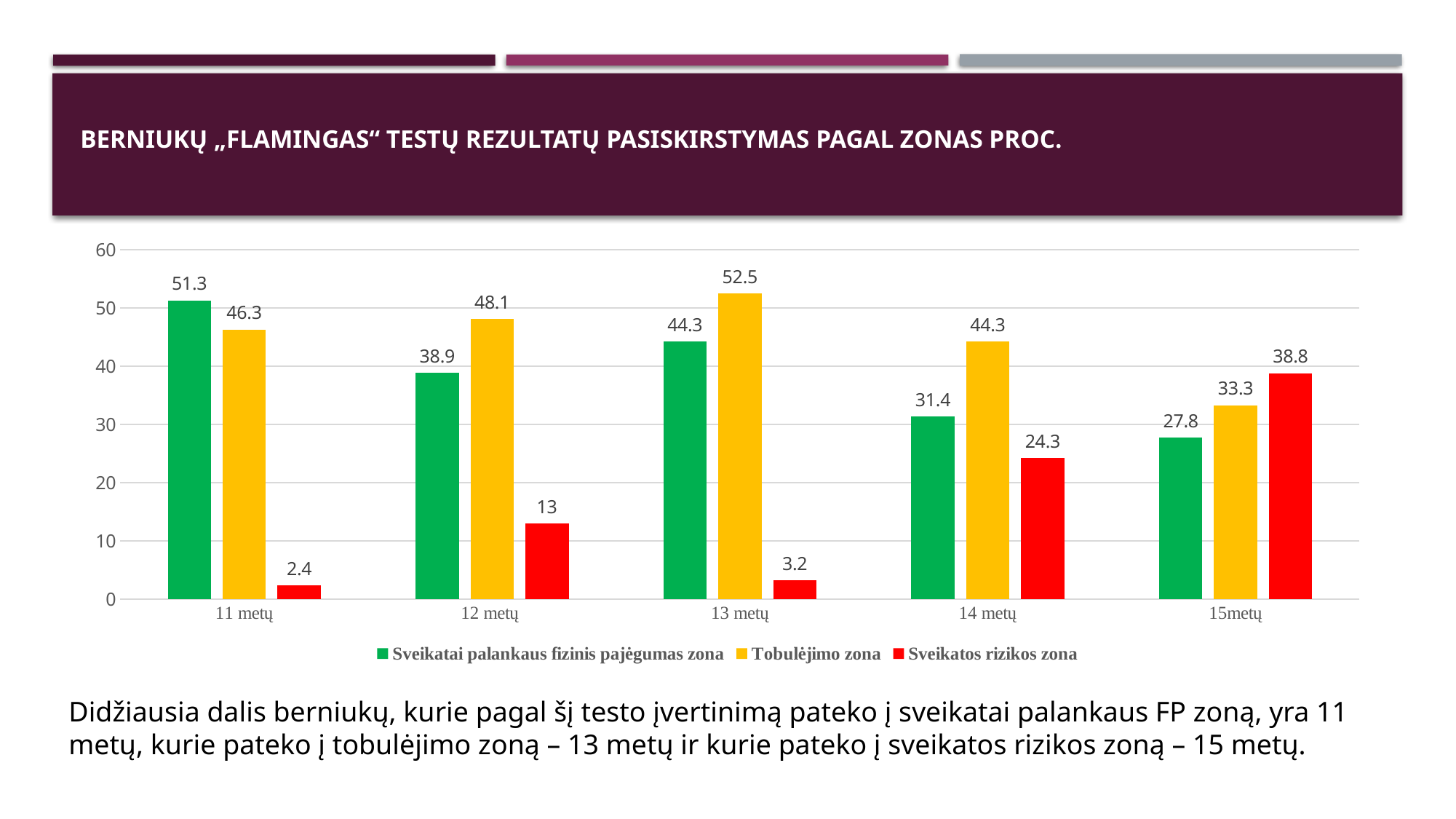
What is the value for Tobulėjimo zona at 13 metų? 52.5 What kind of chart is shown on the slide? Bar chart Which age group has the highest value for Sveikatos rizikos zona? 15metų What is the difference between the Tobulėjimo zona value and the Sveikatos rizikos zona value at 14 metų? 20 What is the value for Sveikatai palankaus fizinis pajėgumas zona at 11 metų? 51.3 Which age group has the lowest value for Sveikatai palankaus fizinis pajėgumas zona? 15metų At 15metų, which is larger: Tobulėjimo zona or Sveikatos rizikos zona? Sveikatos rizikos zona What colour represents Sveikatos rizikos zona in the chart? Red What is the value for Sveikatos rizikos zona at 12 metų? 13 How many series does the legend list? 3 How many age groups are shown on the x axis? 5 Do the values for Sveikatai palankaus fizinis pajėgumas zona rise or fall from 13 metų to 15metų? Fall